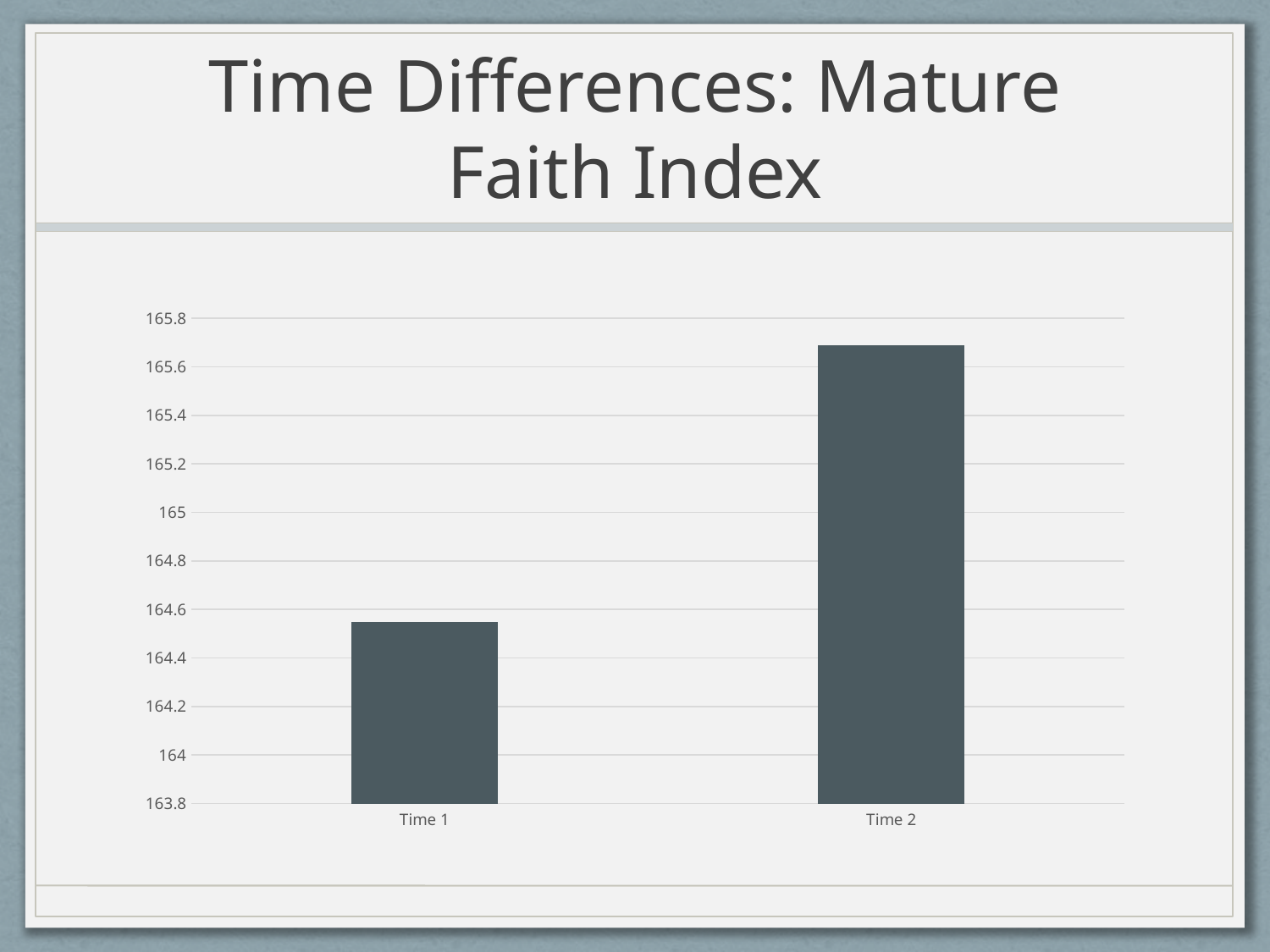
Which is larger, the value for Time 1 or the value for Time 2? Time 2 Is the value for Time 2 greater or less than 165.4? greater Is the value for Time 1 greater or less than 165? less Is the value for Time 2 greater or less than 165? greater What type of chart is shown on the slide? bar chart What is the title of the slide containing the chart? Time Differences: Mature Faith Index What is the highest value shown on the y axis? 165.8 Do the values rise or fall from Time 1 to Time 2? rise How many categories are plotted on the x axis? 2 Which category has the highest value? Time 2 Which category has the lowest value? Time 1